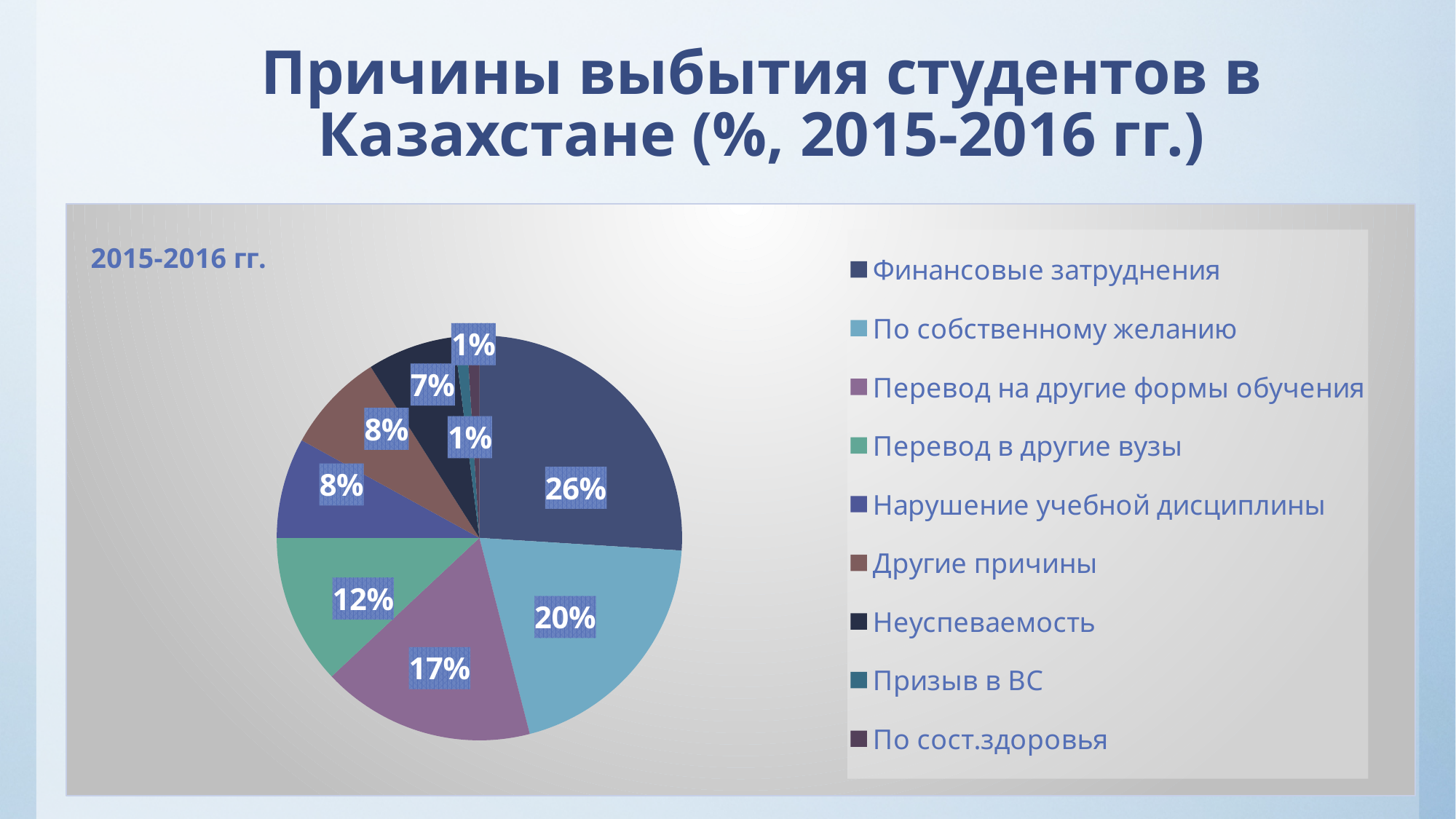
What percentage of the pie is attributed to Финансовые затруднения? 26% What is the value for Перевод на другие формы обучения? 17% How many entries does the legend list? 9 What share does По собственному желанию have in the pie chart? 20% What is the value for Неуспеваемость? 7% What kind of chart is shown on the slide? pie chart What is the smallest percentage shown on the pie chart? 1% Which is larger: the share for Перевод в другие вузы or the share for Неуспеваемость? Перевод в другие вузы Which reason has the largest share of the pie? Финансовые затруднения What percentage is shown for Перевод в другие вузы? 12% What is the difference between the shares of Финансовые затруднения and По собственному желанию? 6% What is the title shown above the pie chart? 2015-2016 гг.